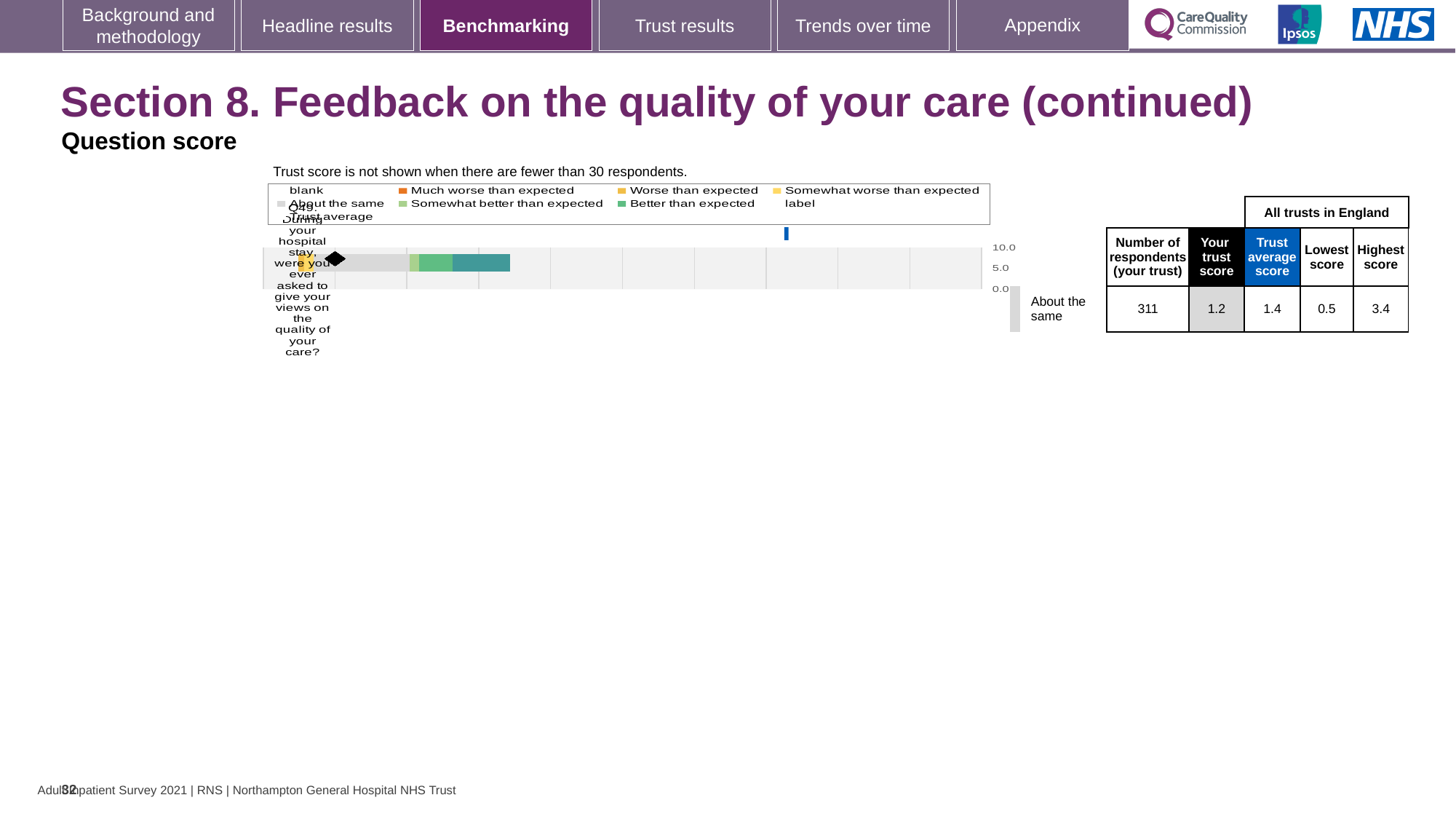
What is the difference between the highest score and the lowest score for Q49? 2.9 Is your trust score for Q49 greater or less than 5.0? less What kind of chart is used to show the Q49 question score? Bar chart What benchmark category is shown for Q49 next to the chart? About the same By how much does the trust average score exceed your trust score for Q49? 0.2 What is the lowest score across all trusts in England for Q49? 0.5 What is the 'Your trust score' value for Q49 (During your hospital stay, were you ever asked to give your views on the quality of your care?)? 1.2 What is the trust average score for Q49? 1.4 What is the highest score across all trusts in England for Q49? 3.4 Which is larger for Q49: your trust score or the trust average score? Trust average score How many questions are plotted on the chart? 1 How many respondents from your trust answered Q49? 311